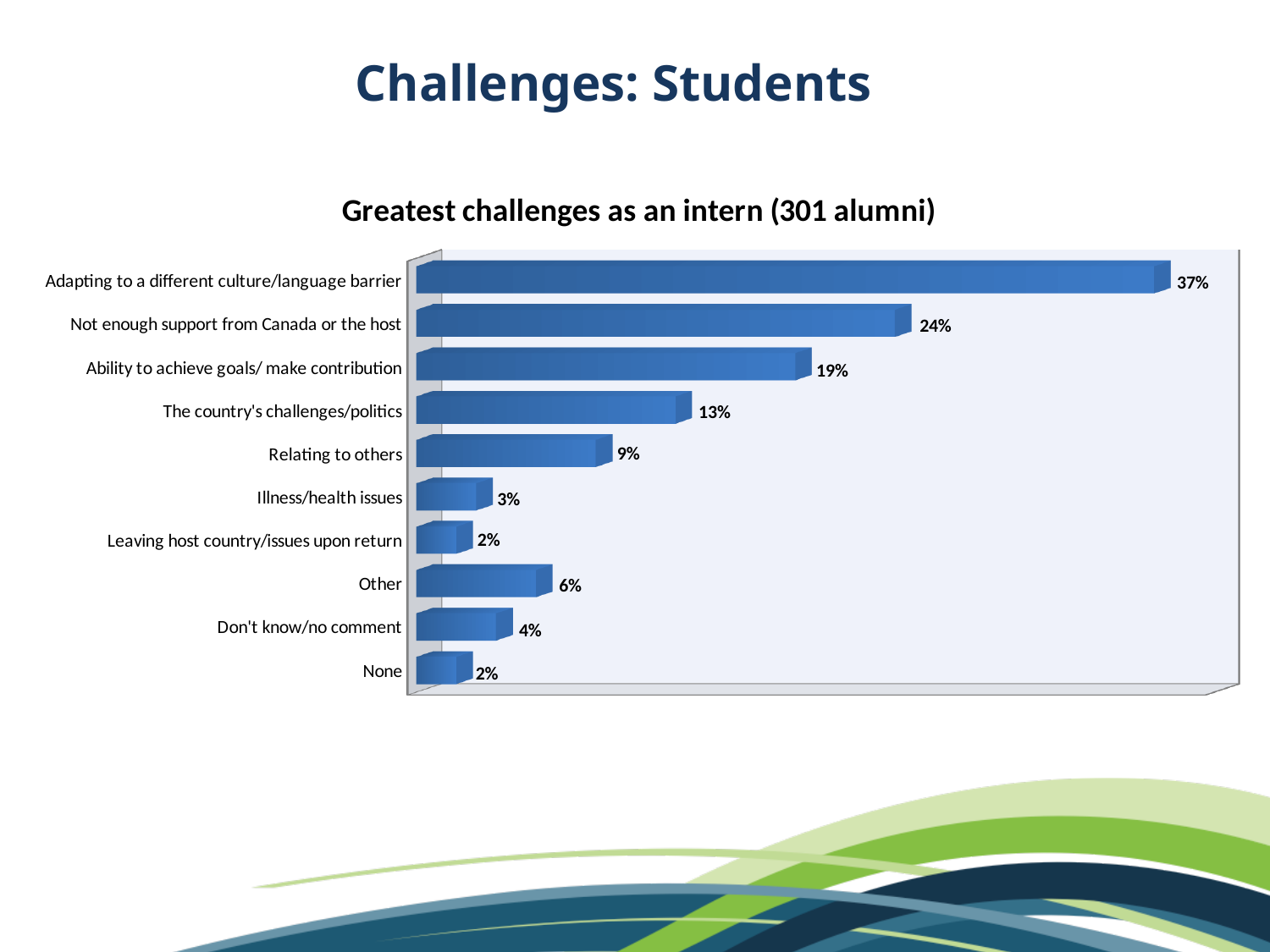
How many challenge categories are shown in the chart? 10 What percentage is shown for 'Relating to others'? 9% What is the difference between 'Adapting to a different culture/language barrier' and 'Not enough support from Canada or the host'? 13% What type of chart is shown on the slide? Bar chart What is the title of the chart? Greatest challenges as an intern (301 alumni) Which challenge has the highest percentage? Adapting to a different culture/language barrier What is the value for 'Not enough support from Canada or the host'? 24% What percentage of alumni cited adapting to a different culture/language barrier as their greatest challenge? 37% What is the difference between 'Ability to achieve goals/ make contribution' and 'The country's challenges/politics'? 6% Which is larger: 'Relating to others' or 'Don't know/no comment'? Relating to others What is the value for 'Don't know/no comment'? 4% Which is larger: 'Other' or 'Illness/health issues'? Other